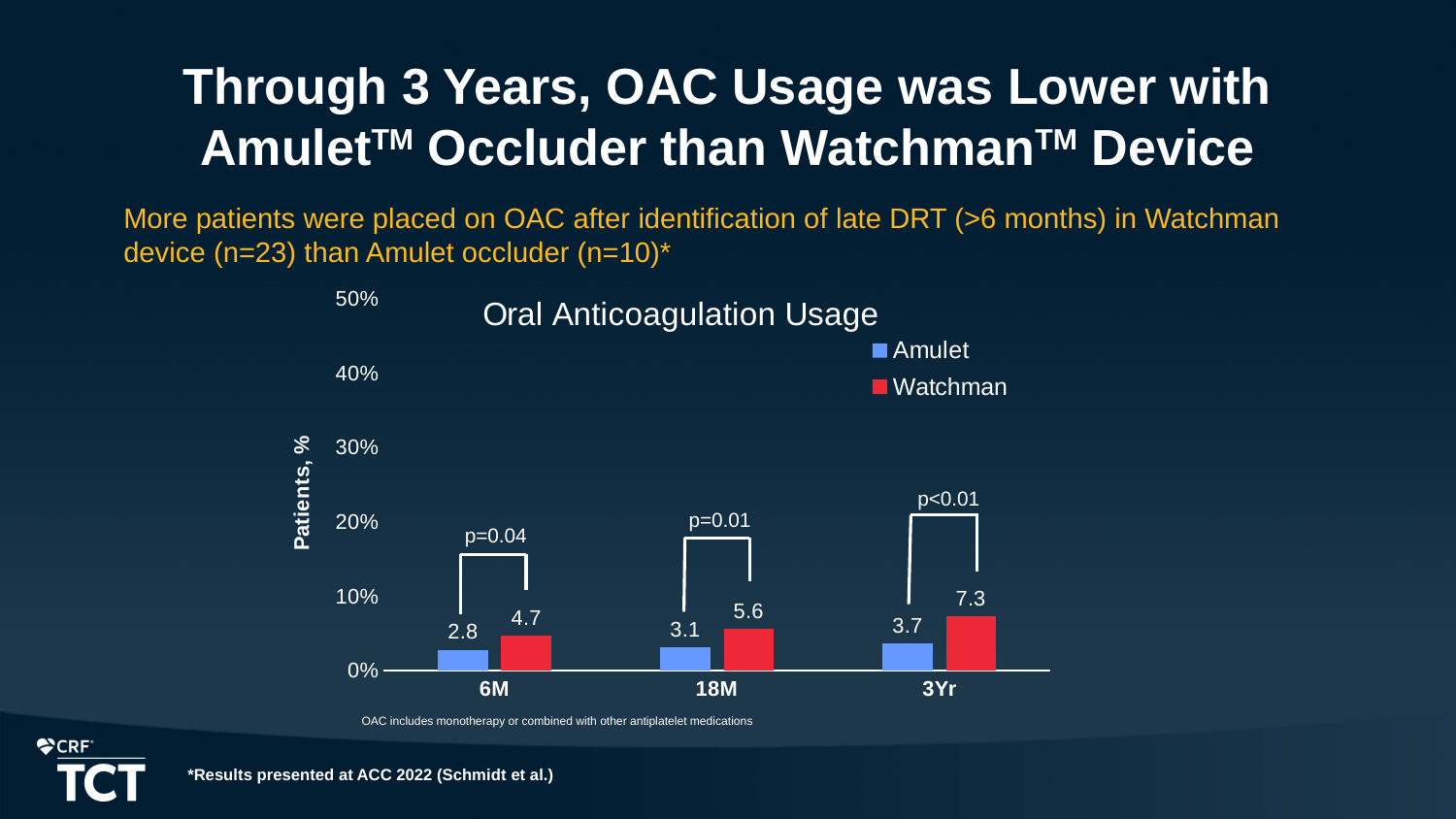
At which time point is the Watchman value highest? 3Yr Do the Amulet values rise or fall from 6M to 3Yr? rise What is the value for Watchman at 3Yr? 7.3 How many series does the legend list? 2 What is the difference between the Watchman and Amulet values at 3Yr? 3.6 What kind of chart is shown? bar chart Is the value for Watchman at 3Yr greater or less than 10%? less Which is larger at 18M, the Amulet value or the Watchman value? Watchman What is the value for Amulet at 6M? 2.8 How many time points are shown on the x axis? 3 At which time point is the Amulet value lowest? 6M What is the value for Watchman at 18M? 5.6